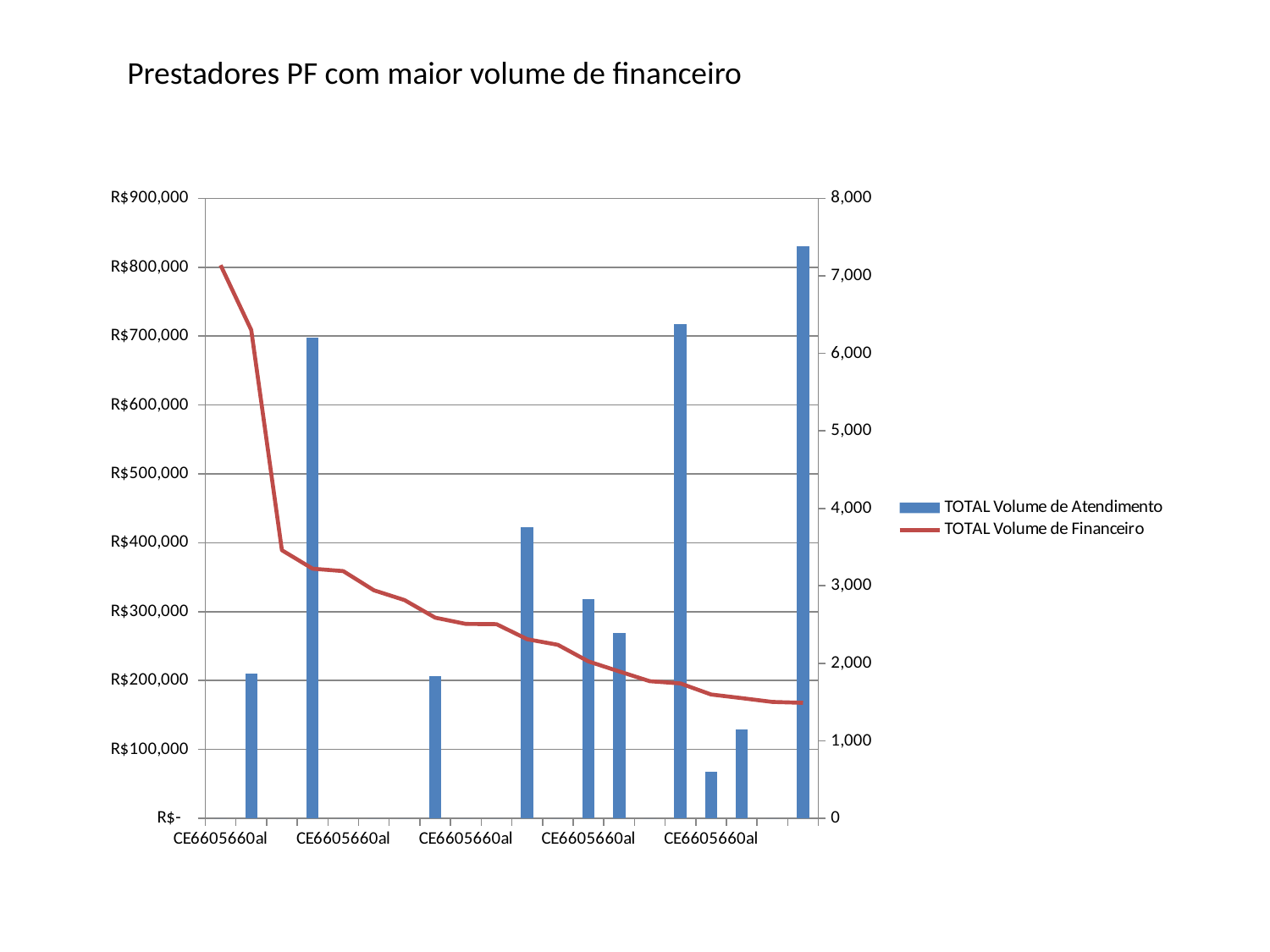
Which is larger for TOTAL Volume de Atendimento, the first bar or the second bar from the left? The second bar How many bars are plotted for TOTAL Volume de Atendimento? 10 Which bar is the tallest for TOTAL Volume de Atendimento? The rightmost bar Is the last (rightmost) value of the TOTAL Volume de Financeiro line greater or less than R$200,000? less What is the title of the chart? Prestadores PF com maior volume de financeiro What kind of chart is shown on the slide? A combination bar and line chart Is the value of the rightmost TOTAL Volume de Atendimento bar greater or less than 7,000? greater Does the TOTAL Volume de Financeiro line rise or fall from left to right? Fall Is the value of the leftmost TOTAL Volume de Atendimento bar greater or less than 3,000? less How many series does the legend list? 2 Which series is drawn as a red line? TOTAL Volume de Financeiro